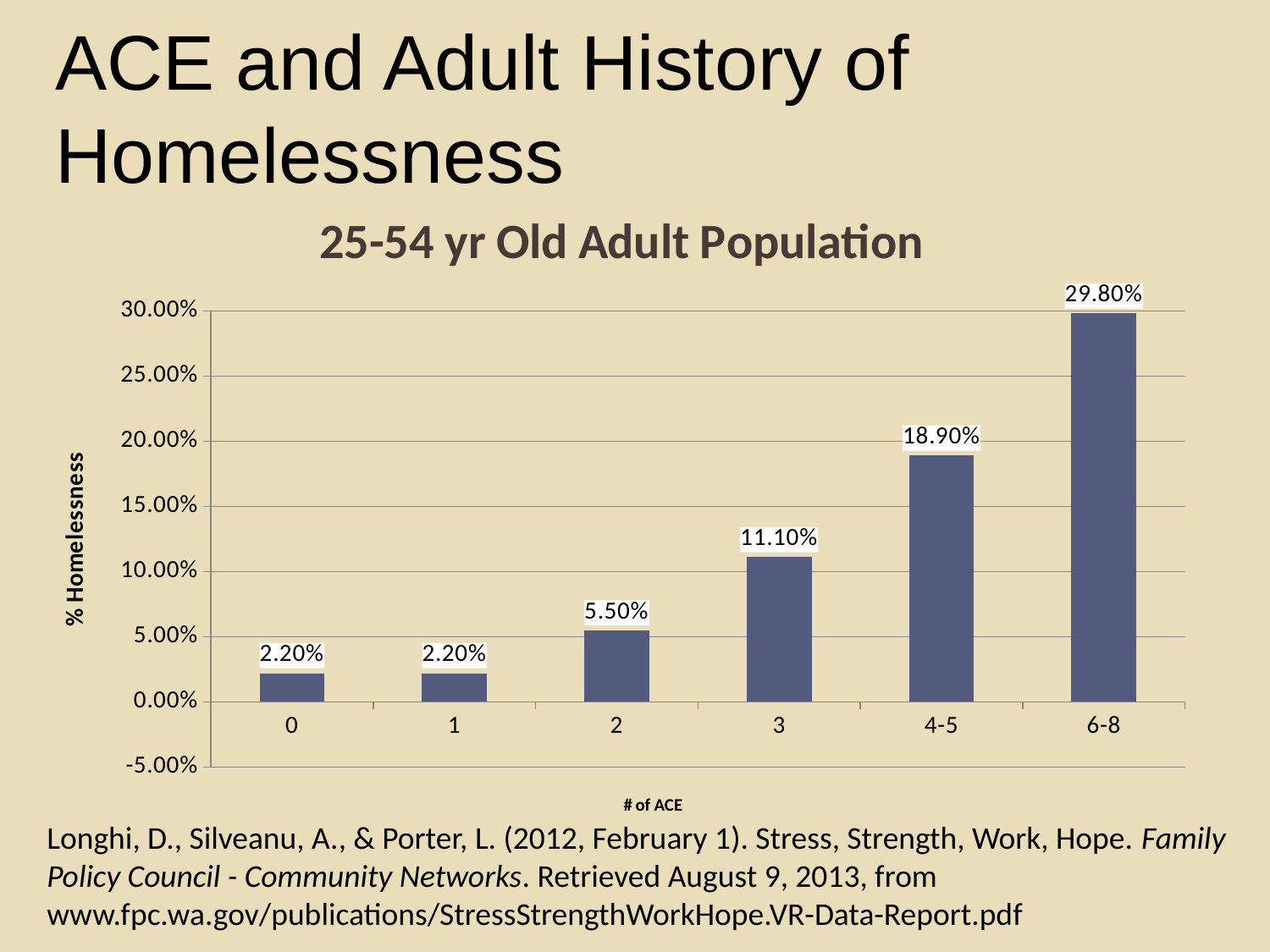
Is the value for 4-5 ACEs greater or less than 15.00%? greater Which # of ACE category has the highest % Homelessness? 6-8 Do the % Homelessness values rise or fall as the # of ACE increases along the x axis? rise What is the difference in % Homelessness between 3 ACEs and 2 ACEs? 5.60% What is the title of the chart? 25-54 yr Old Adult Population Which has a higher % Homelessness, 4-5 ACEs or 3 ACEs? 4-5 What is the % Homelessness value for 2 ACEs? 5.50% What kind of chart is shown on the slide? bar chart How many # of ACE categories are shown on the x axis? 6 What is the % Homelessness value for the 6-8 ACE category? 29.80% What is the % Homelessness value for 3 ACEs? 11.10% What is the difference in % Homelessness between the 6-8 and 4-5 ACE categories? 10.90%